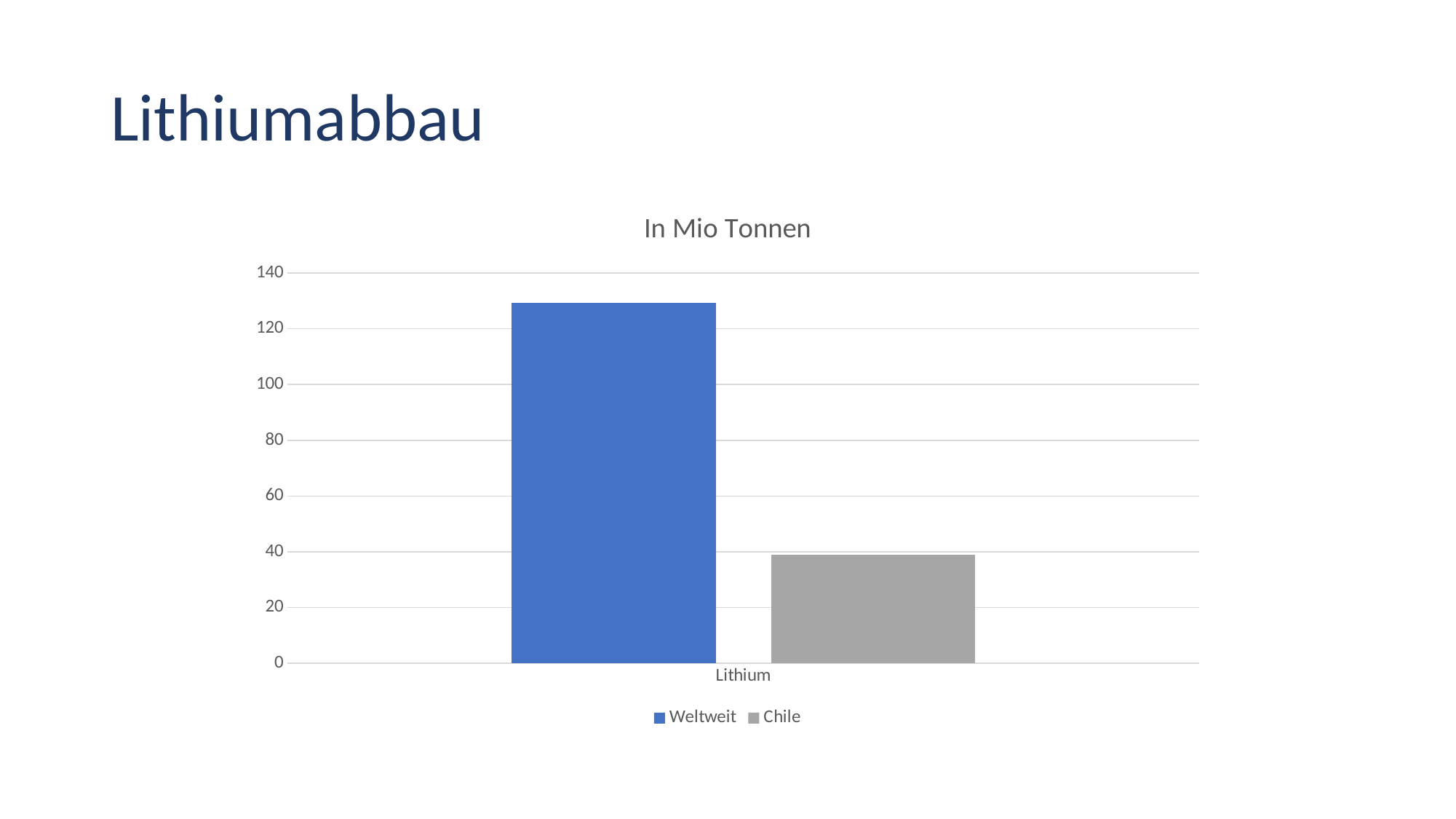
How many categories are shown on the x axis? 1 Is the value for Chile greater or less than 20? greater What is the category label on the x axis? Lithium Is the value for Weltweit greater or less than 140? less What is the title of the chart? In Mio Tonnen Is the value for Weltweit greater or less than 120? greater How many series does the legend list? 2 What kind of chart is shown on the slide? bar chart Which series are listed in the legend? Weltweit, Chile Which series has the lowest value? Chile Which series has the higher value for Lithium, Weltweit or Chile? Weltweit